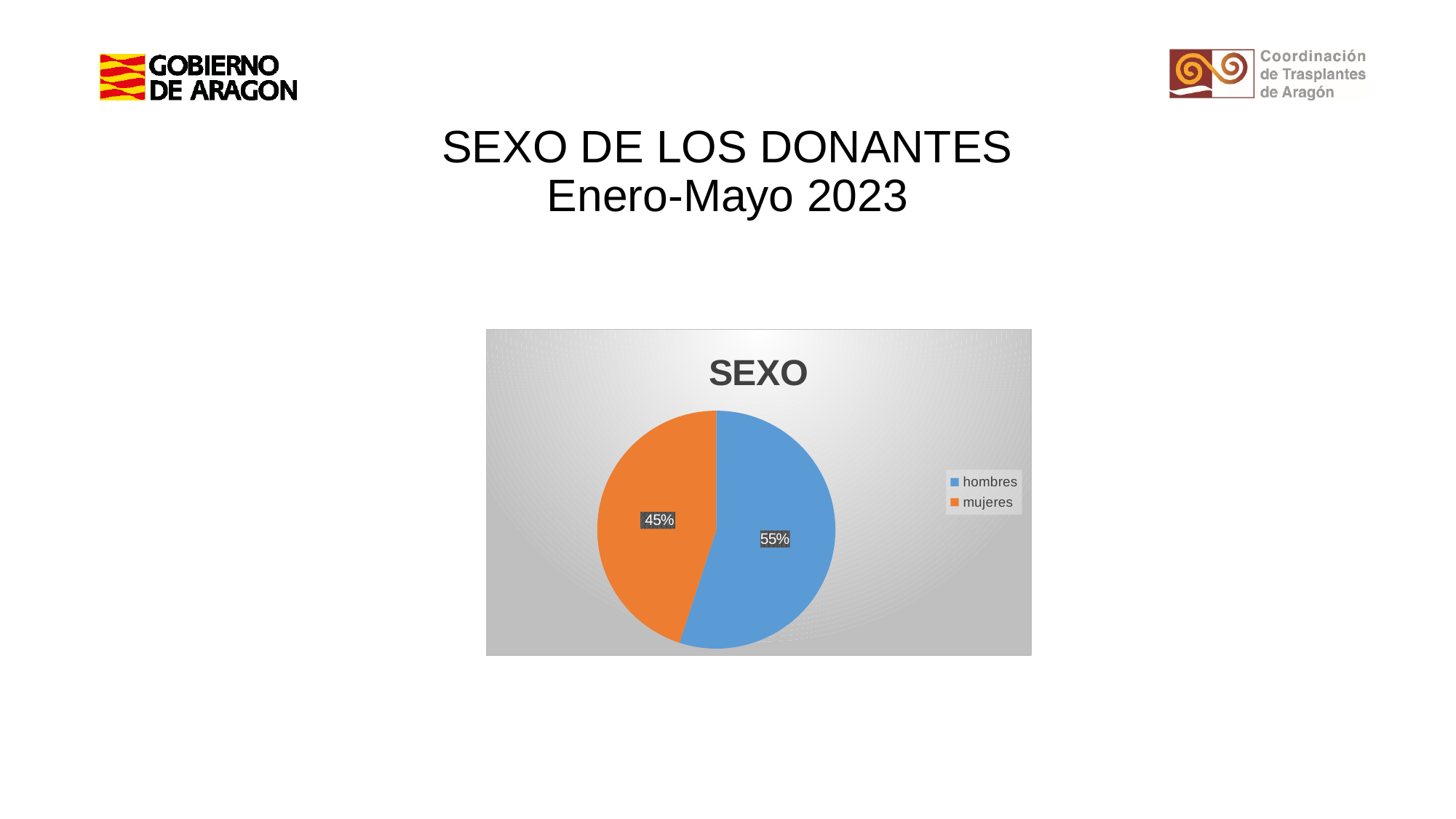
What kind of chart is shown on the slide? pie chart How many entries does the chart legend list? 2 How many slices does the pie chart have? 2 Which slice is larger, hombres or mujeres? hombres What colour is the mujeres slice in the pie chart? orange Which category has the smallest share of the pie chart? mujeres What is the title of the chart? SEXO What is the difference in percentage points between the hombres and mujeres slices? 10 Which category has the largest share of the pie chart? hombres What percentage of the pie chart is labelled for hombres? 55% What percentage of the pie chart is labelled for mujeres? 45%